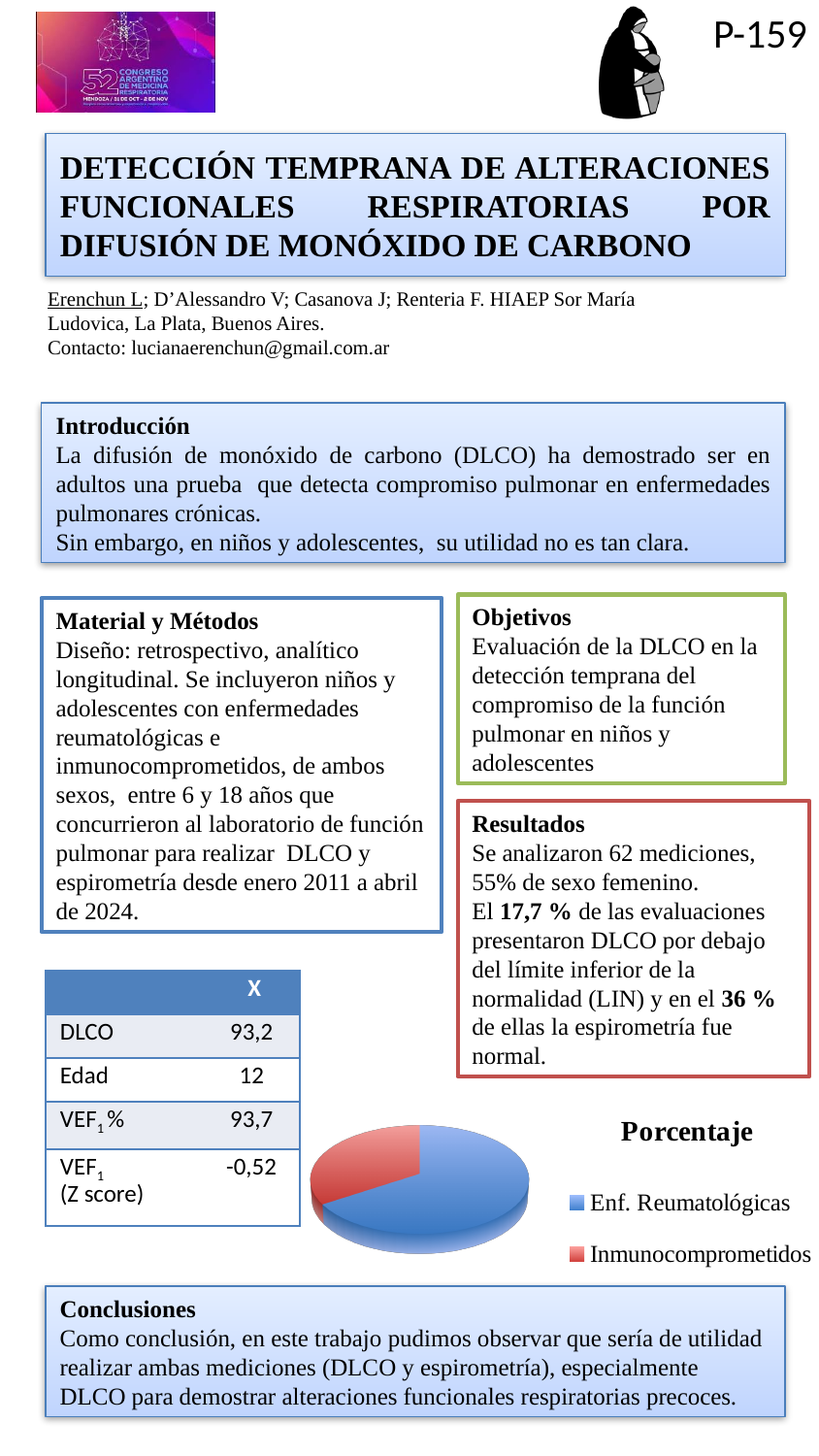
What is the title of the pie chart? Porcentaje How many categories does the pie chart's legend list? 2 Which category has the smallest slice in the pie chart? Inmunocomprometidos Which category has the largest slice in the pie chart? Enf. Reumatológicas In the pie chart, which slice is larger: Enf. Reumatológicas or Inmunocomprometidos? Enf. Reumatológicas What kind of chart is shown on the slide? pie chart What colour is the Inmunocomprometidos slice in the pie chart? red